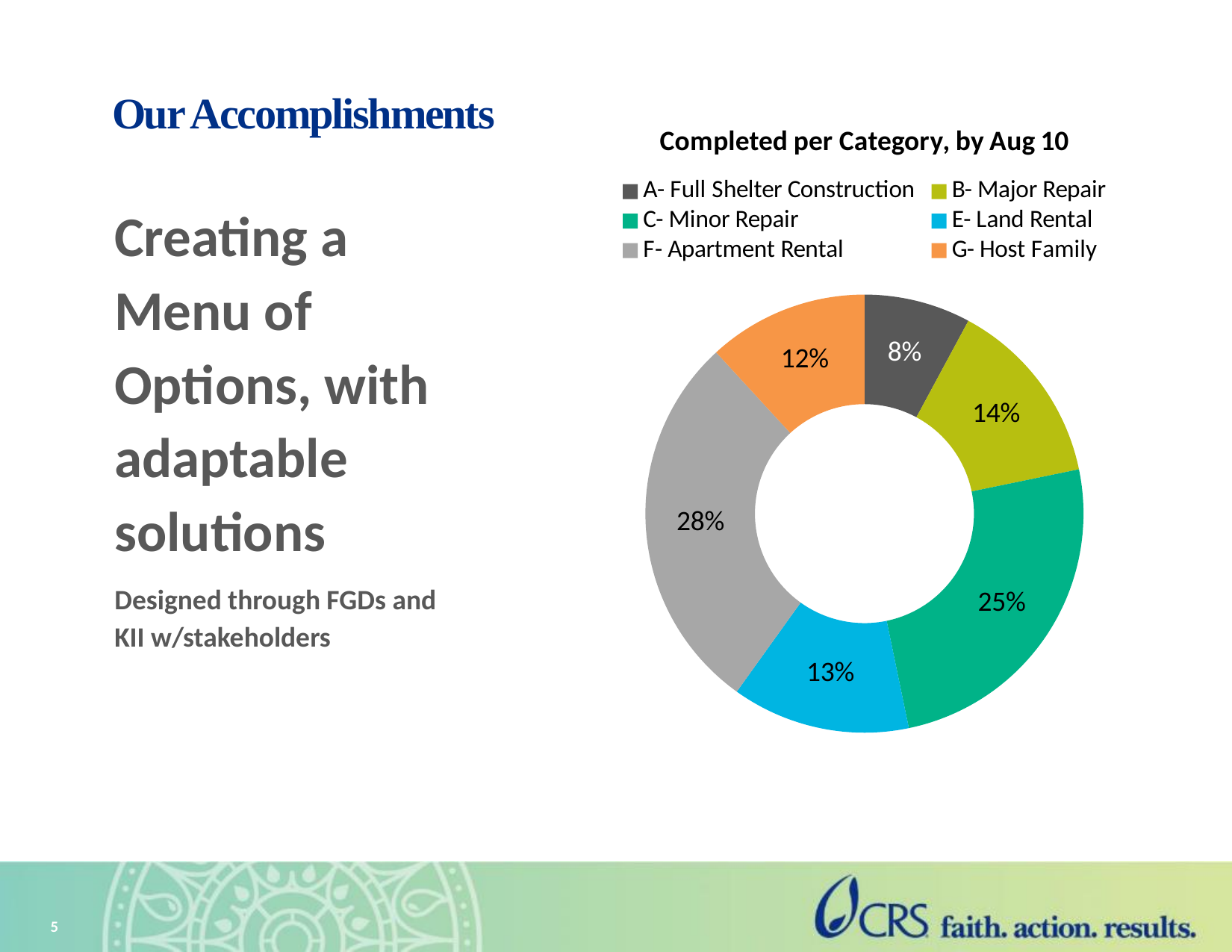
How many categories does the chart show? 6 What share of the chart is A- Full Shelter Construction? 8% What share of the chart is E- Land Rental? 13% What is the difference in percentage points between F- Apartment Rental and B- Major Repair? 14 What is the title of the chart? Completed per Category, by Aug 10 What share of the chart is G- Host Family? 12% Which category has the largest share of the chart? F- Apartment Rental Which category has the smallest share of the chart? A- Full Shelter Construction What kind of chart is shown on the slide? Doughnut chart Which has a larger share, C- Minor Repair or E- Land Rental? C- Minor Repair